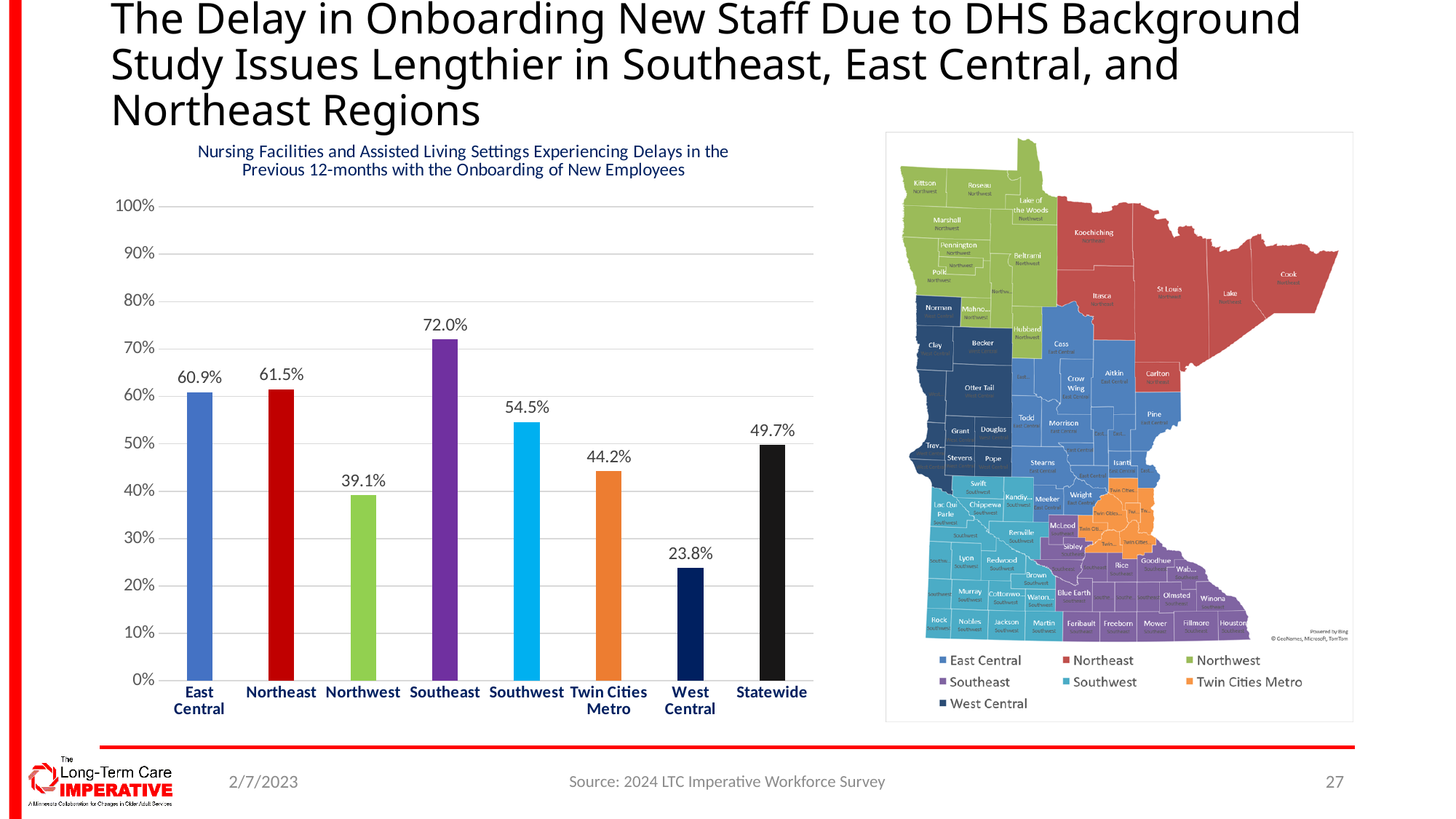
What is the title of the bar chart? Nursing Facilities and Assisted Living Settings Experiencing Delays in the Previous 12-months with the Onboarding of New Employees What kind of chart is used to show the delay percentages? bar chart What is the Statewide value? 49.7% Which region has the highest value? Southeast Which is larger, the value for Southwest or the value for Twin Cities Metro? Southwest What is the difference between the Southeast and Northwest values? 32.9% What is the value for West Central? 23.8% How many categories are shown on the x axis of the bar chart? 8 Which region has the lowest value? West Central How many regions are listed in the legend of the map? 7 What is the value for Southeast? 72.0% Is the value for Northwest greater or less than 40%? less